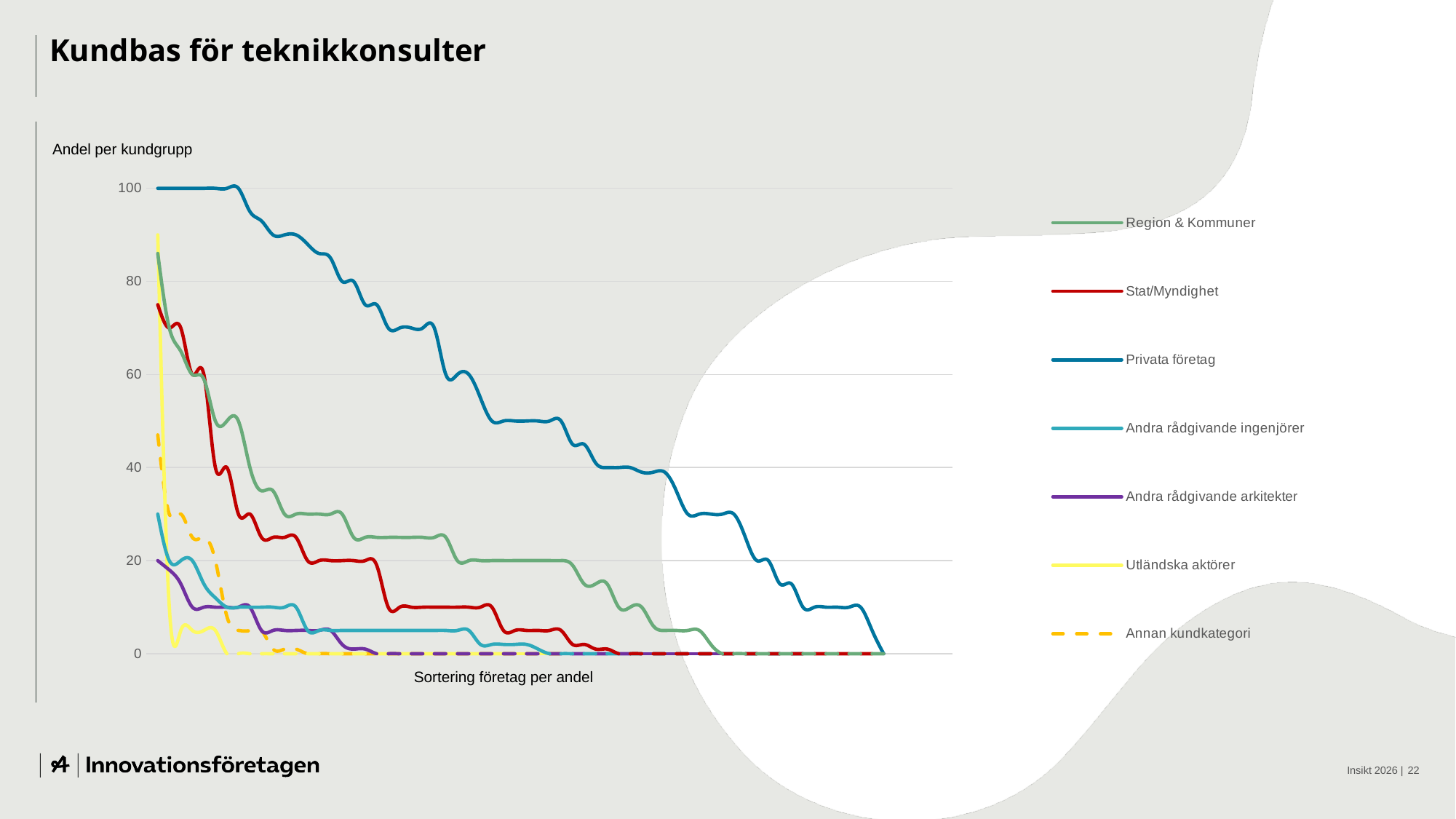
What is the highest value reached by the Privata företag line? 100 How many series does the legend list? 7 Is the starting value of the Stat/Myndighet line greater or less than 60? greater Is the starting value of the Andra rådgivande ingenjörer line greater or less than 20? greater What kind of chart is shown on the slide? line chart What is the title of the slide chart? Kundbas för teknikkonsulter Which legend entry is drawn with a dashed line? Annan kundkategori Which series extends furthest along the x axis before reaching 0? Privata företag Is the starting value of the Annan kundkategori line greater or less than 40? greater Which series reaches the highest value on the chart? Privata företag Do the values for Privata företag rise or fall along the x axis? fall Which series starts at a higher value, Privata företag or Stat/Myndighet? Privata företag